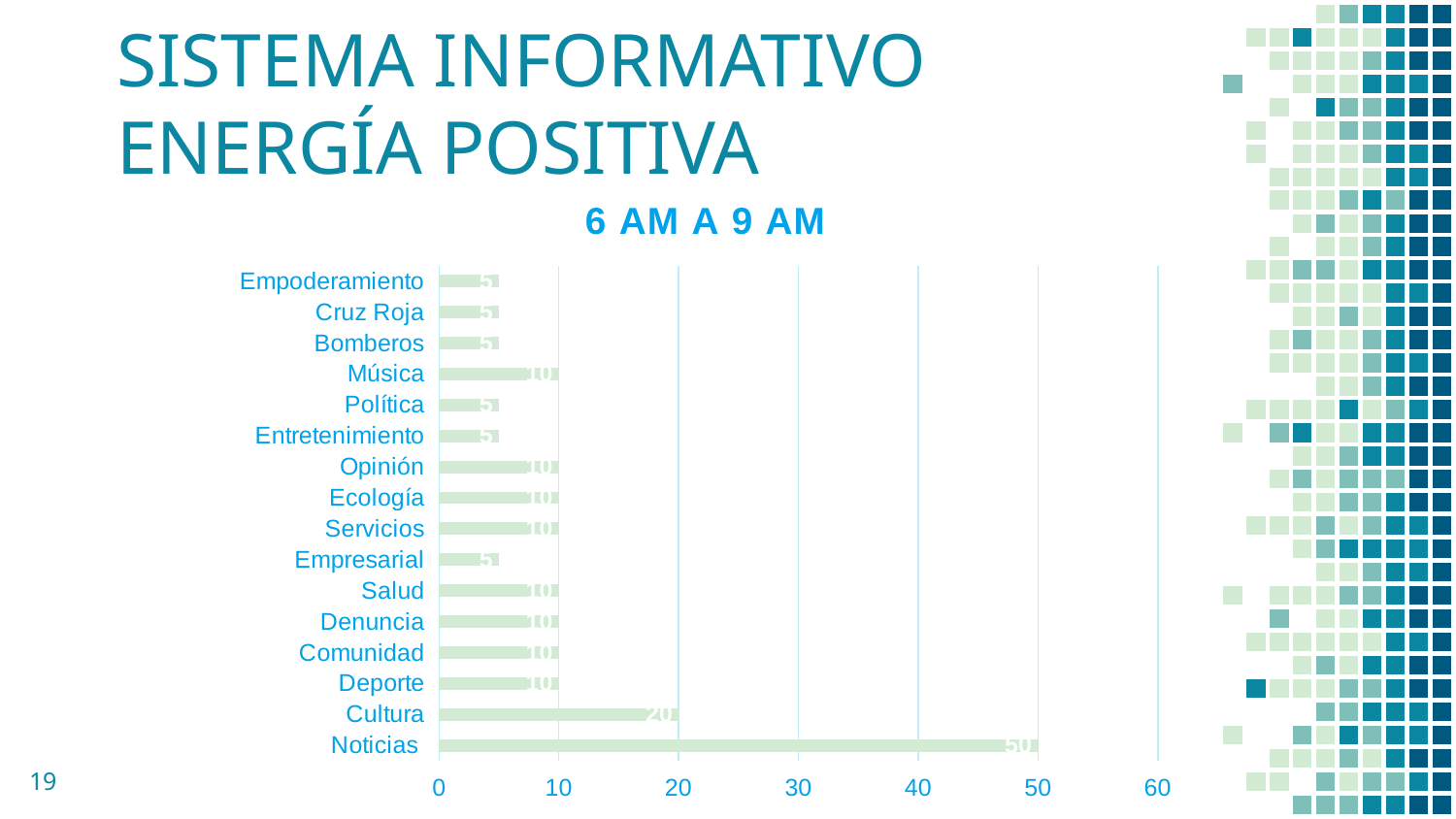
What is the value for Música? 10 How many categories are shown in the chart? 16 What is the value for Cultura? 20 Which is larger, the value for Cultura or the value for Deporte? Cultura What is the highest value shown on the x axis? 60 What is the title of the chart? 6 AM A 9 AM What is the value for Empresarial? 5 Which category has the highest value? Noticias What kind of chart is shown on the slide? bar chart Is the value for Noticias greater or less than 40? greater What is the difference between the values for Noticias and Cultura? 30 What is the value for Noticias? 50